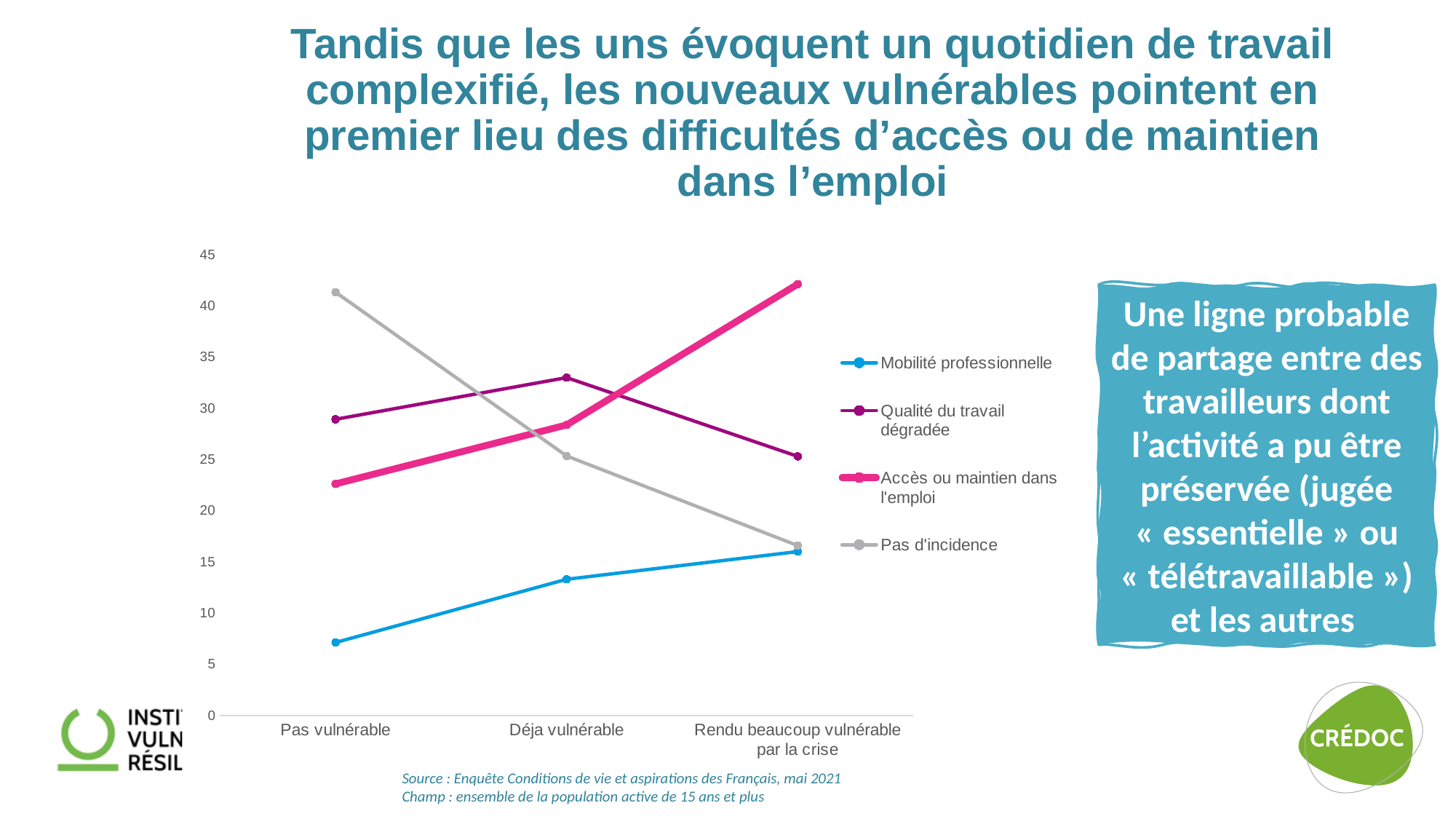
Which series has the highest value for the category "Rendu beaucoup vulnérable par la crise"? Accès ou maintien dans l'emploi Is the value for "Accès ou maintien dans l'emploi" at "Rendu beaucoup vulnérable par la crise" greater or less than 40? greater At "Déja vulnérable", which is larger: "Qualité du travail dégradée" or "Mobilité professionnelle"? Qualité du travail dégradée How many series does the legend list? 4 Does the "Mobilité professionnelle" series rise or fall across the x axis? rise Is the value for "Pas d'incidence" at "Pas vulnérable" greater or less than 40? greater Does the "Pas d'incidence" series rise or fall from "Pas vulnérable" to "Rendu beaucoup vulnérable par la crise"? fall Which series has the lowest value for the category "Pas vulnérable"? Mobilité professionnelle Which series has the highest value for the category "Pas vulnérable"? Pas d'incidence Is the value for "Mobilité professionnelle" at "Pas vulnérable" greater or less than 10? less How many categories are shown on the x axis? 3 What kind of chart is shown on the slide? line chart